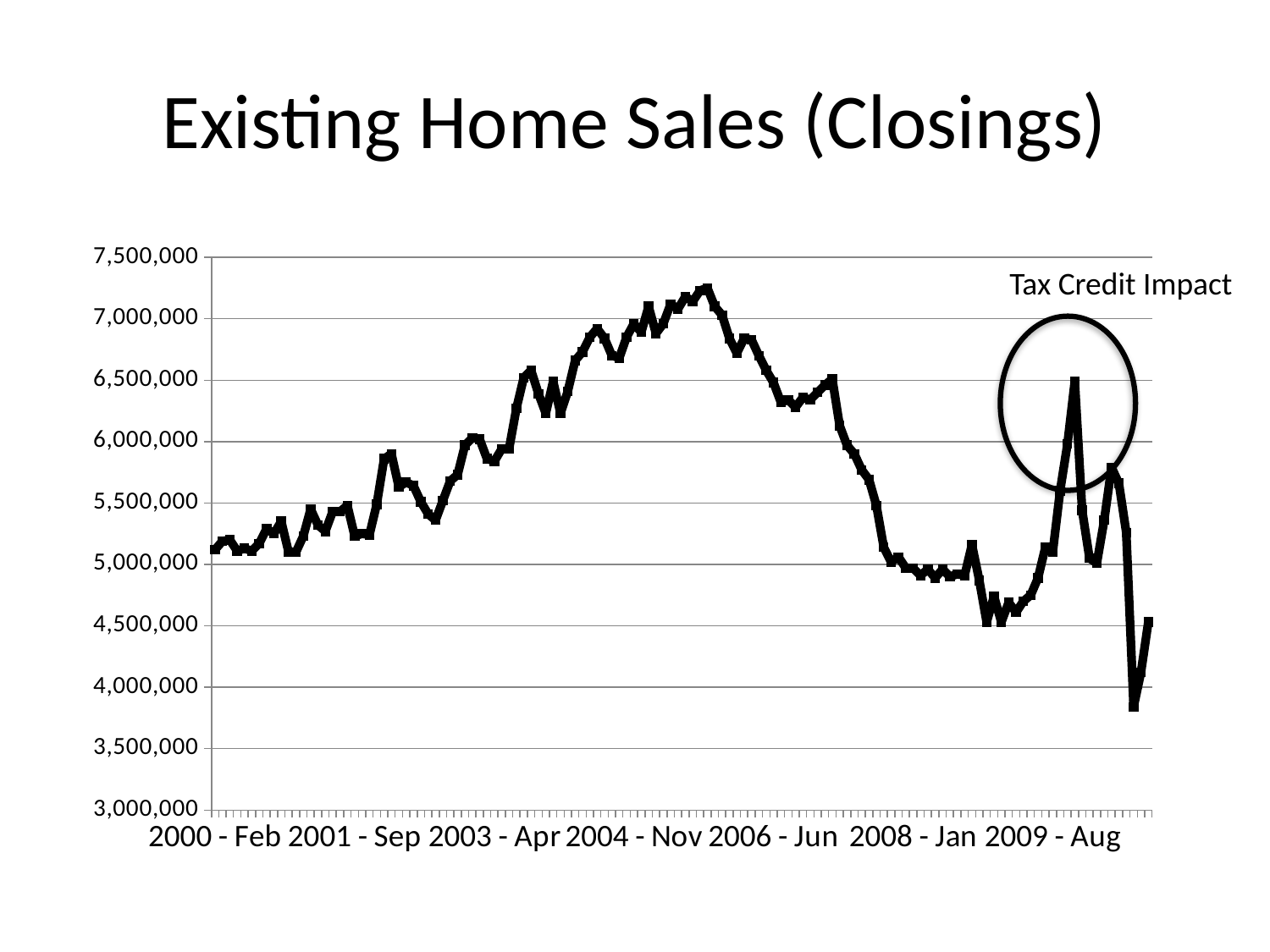
Is the value at 2004 - Nov greater or less than 6,500,000? greater How many date labels are shown along the x axis? 7 Do the values generally rise or fall between 2004 - Nov and 2008 - Jan? fall What kind of chart is shown on the slide? line chart Is the highest point on the line greater or less than 7,000,000? greater Is the lowest point on the line greater or less than 4,000,000? less What text annotation is placed next to the circled spike on the chart? Tax Credit Impact What is the title of the chart? Existing Home Sales (Closings)